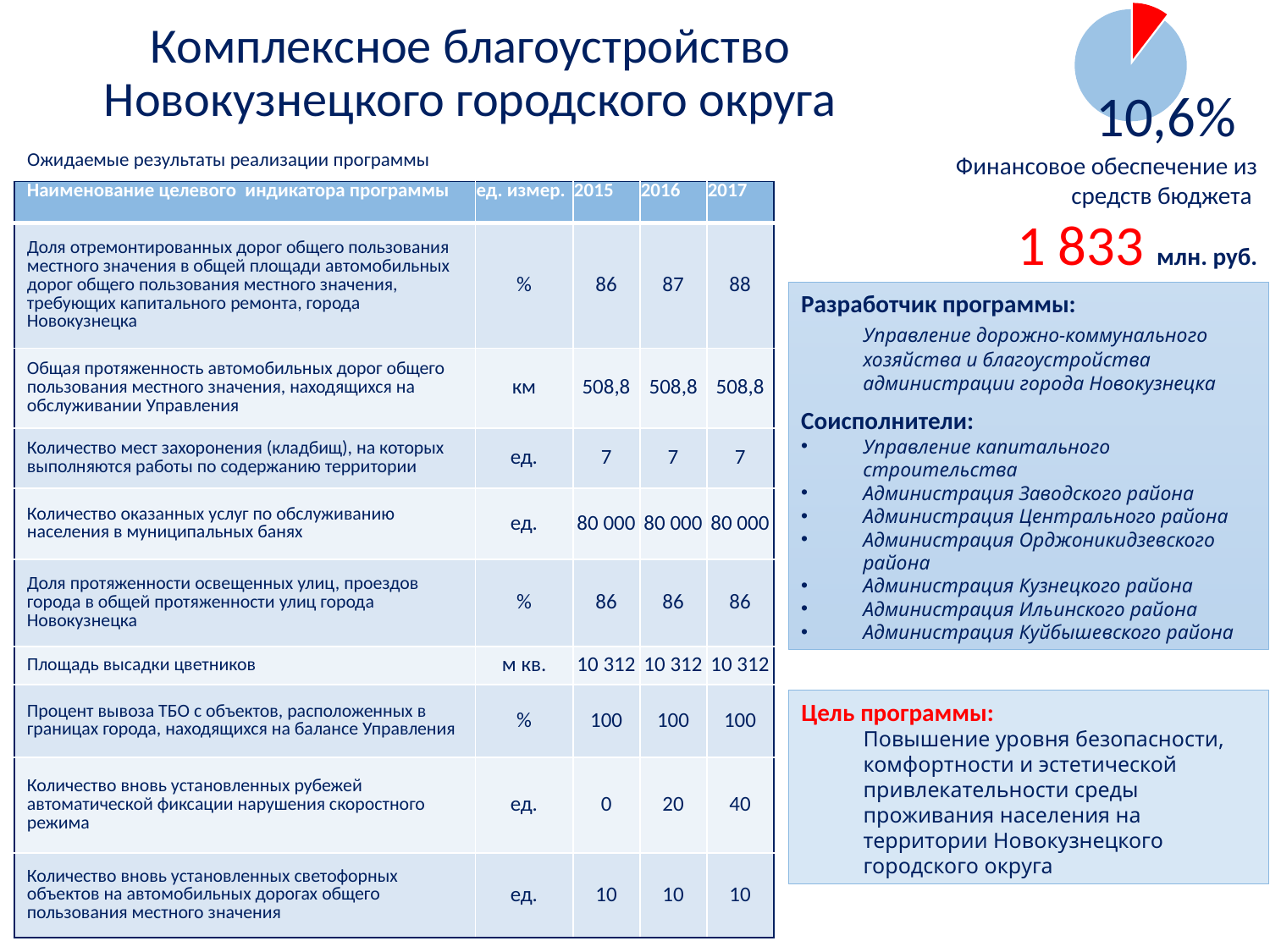
Is the share of the red slice in the pie chart in the top right greater or less than 50%? less What percentage value is printed next to the pie chart in the top right? 10,6% In the pie chart in the top right, which slice is larger, the red one or the blue one? the blue one How many slices does the pie chart in the top right have? 2 What kind of chart is shown in the top right corner of the slide? pie chart What colour is the small slice of the pie chart in the top right? red In the pie chart in the top right, which colour slice is the largest? blue In the pie chart in the top right, what share is labelled for the red slice? 10,6% In the pie chart in the top right, which colour slice is the smallest? red